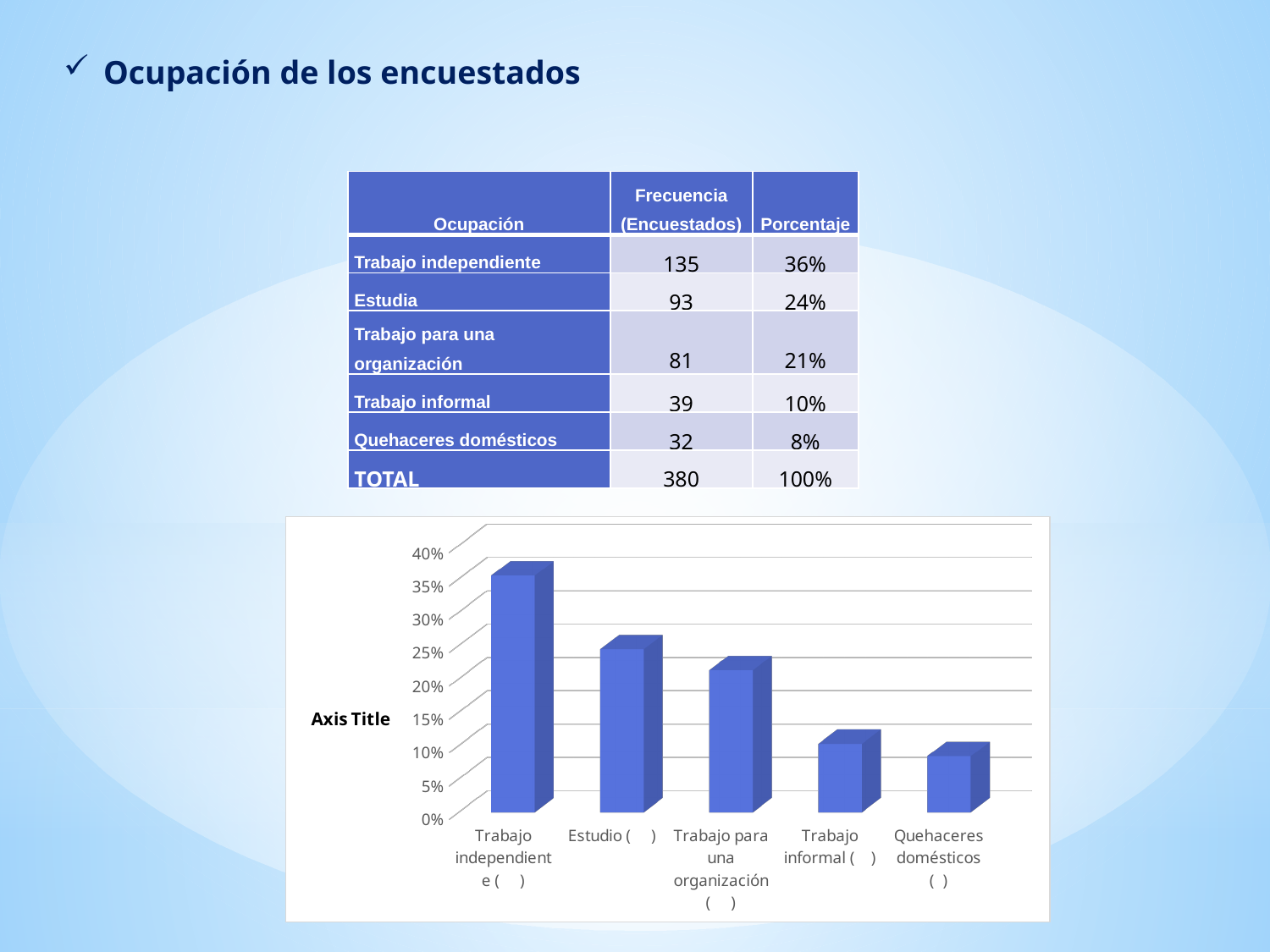
Which category has the shortest bar in the chart? Quehaceres domésticos What is the title shown on the vertical axis of the chart? Axis Title Which category has the tallest bar in the chart? Trabajo independiente What is the highest tick value shown on the vertical axis of the chart? 40% Is the value for Trabajo independiente greater or less than 30%? greater Which is larger in the chart, the bar for Estudio or the bar for Trabajo informal? Estudio How many categories are plotted on the x axis of the chart? 5 Is the value for Estudio greater or less than 20%? greater Is the value for Trabajo para una organización greater or less than 25%? less What kind of chart is shown on the slide? bar chart Do the bar values rise or fall from left to right along the x axis? fall